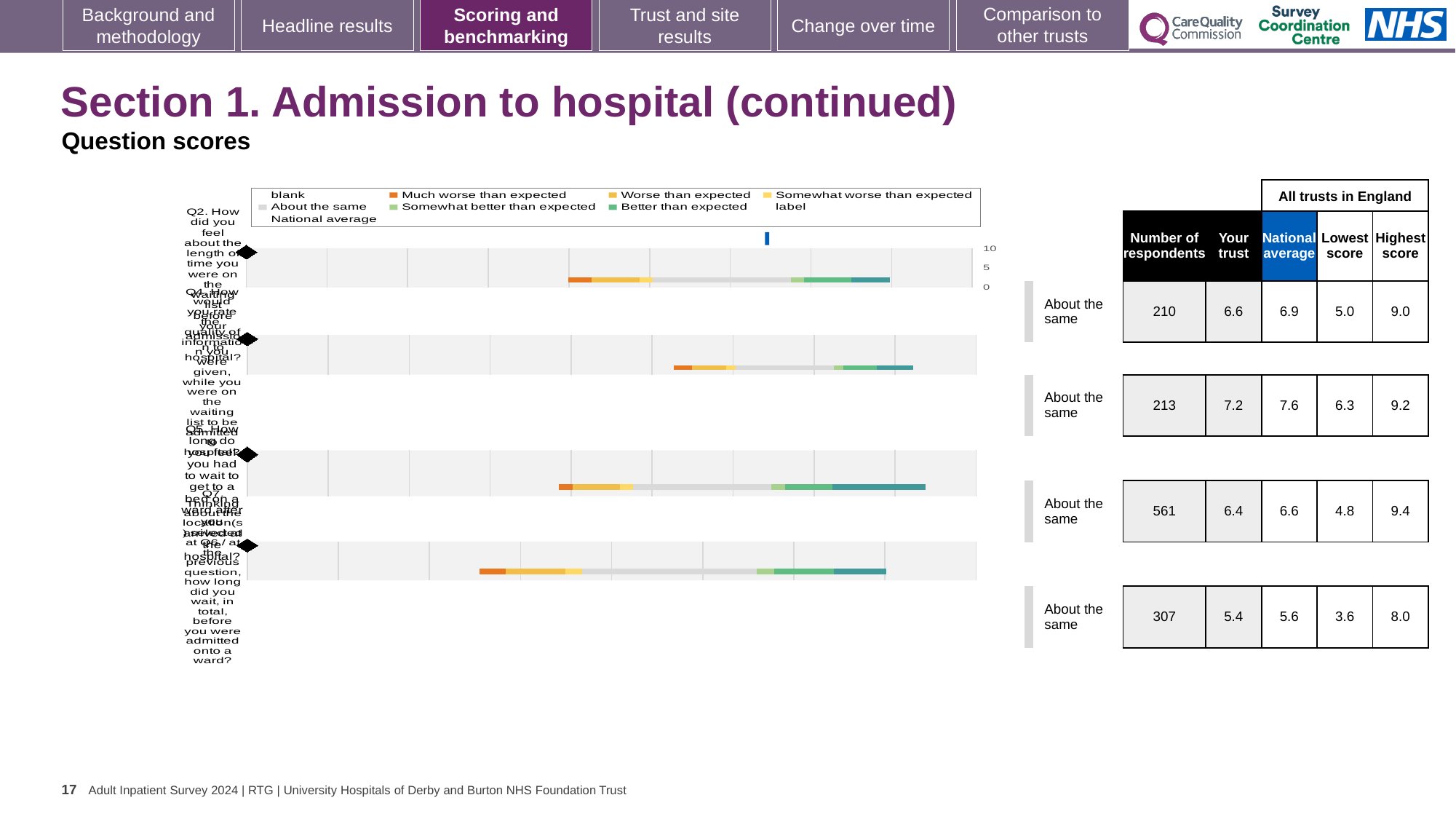
In the table beside the chart, what is the 'Your trust' score for the first row? 6.6 In the table beside the chart, what is the lowest score for the third row? 4.8 In the table beside the chart, which is larger for the second row: the 'Your trust' score or the national average? National average What benchmark category is shown for every question on the slide? About the same Which legend entry is shown in dark teal? Better than expected In the table beside the chart, what is the national average for the second row? 7.6 What is the highest value shown on the chart's numeric axis? 10 What kind of chart is shown on the slide? bar chart How many horizontal bars does the chart contain? 4 In the table beside the chart, what is the number of respondents for the fourth row? 307 In the table beside the chart, which row has the highest number of respondents? the third row (561) In the table beside the chart, what is the difference between the national average and the 'Your trust' score in the first row? 0.3